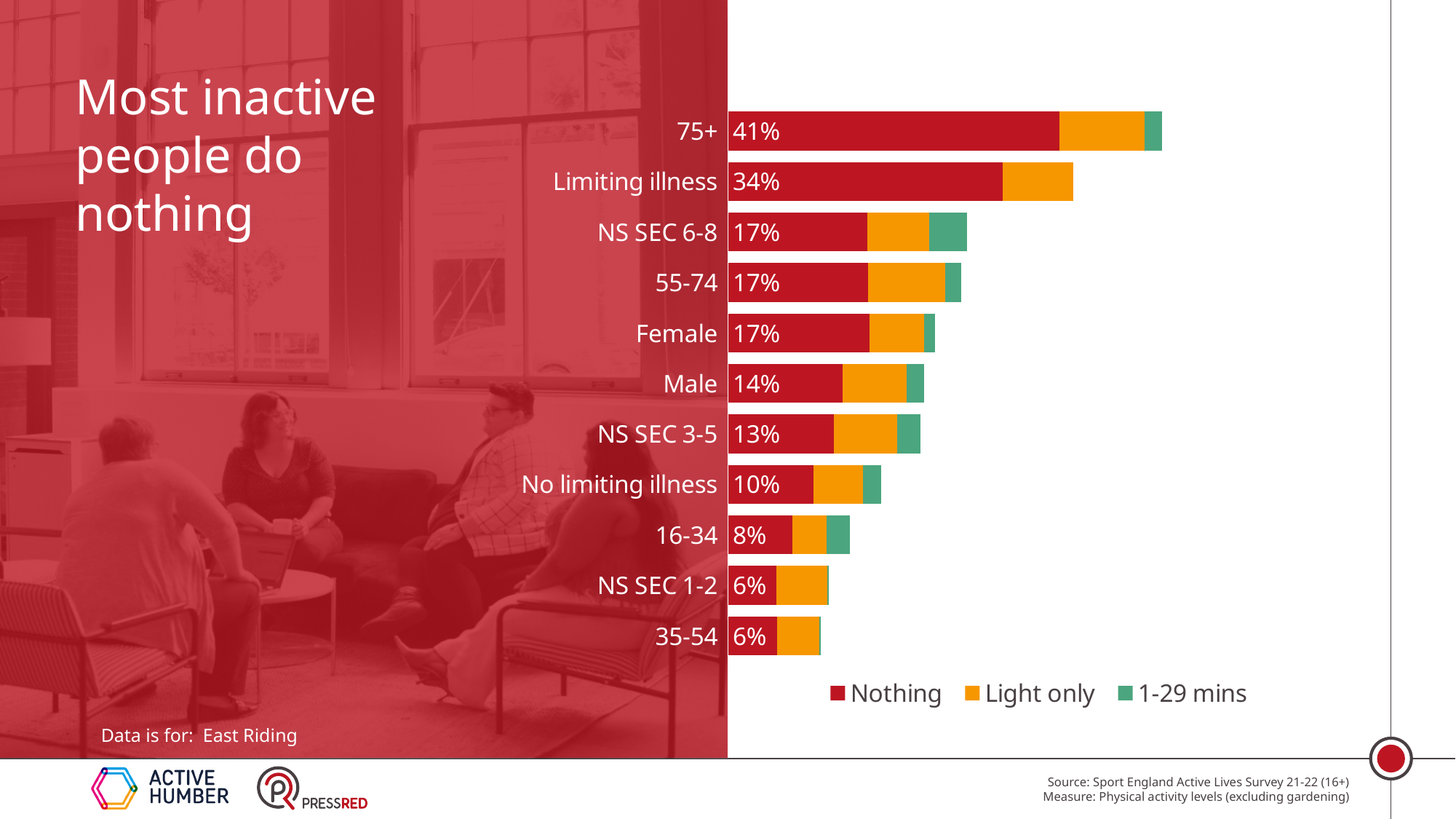
What kind of chart is shown on the slide? Stacked bar chart How many series does the legend list? 3 Which category has the highest 'Nothing' value? 75+ Which has a larger 'Nothing' value, NS SEC 6-8 or NS SEC 1-2? NS SEC 6-8 What is the 'Nothing' value for the Male category? 14% What is the 'Nothing' value for the 16-34 category? 8% What is the difference between the 'Nothing' values for 75+ and Limiting illness? 7% What is the 'Nothing' value for the 75+ category? 41% What is the difference between the 'Nothing' values for Female and Male? 3% How many categories are shown in the chart? 11 What are the three series named in the legend? Nothing, Light only, 1-29 mins What is the 'Nothing' value for the Limiting illness category? 34%